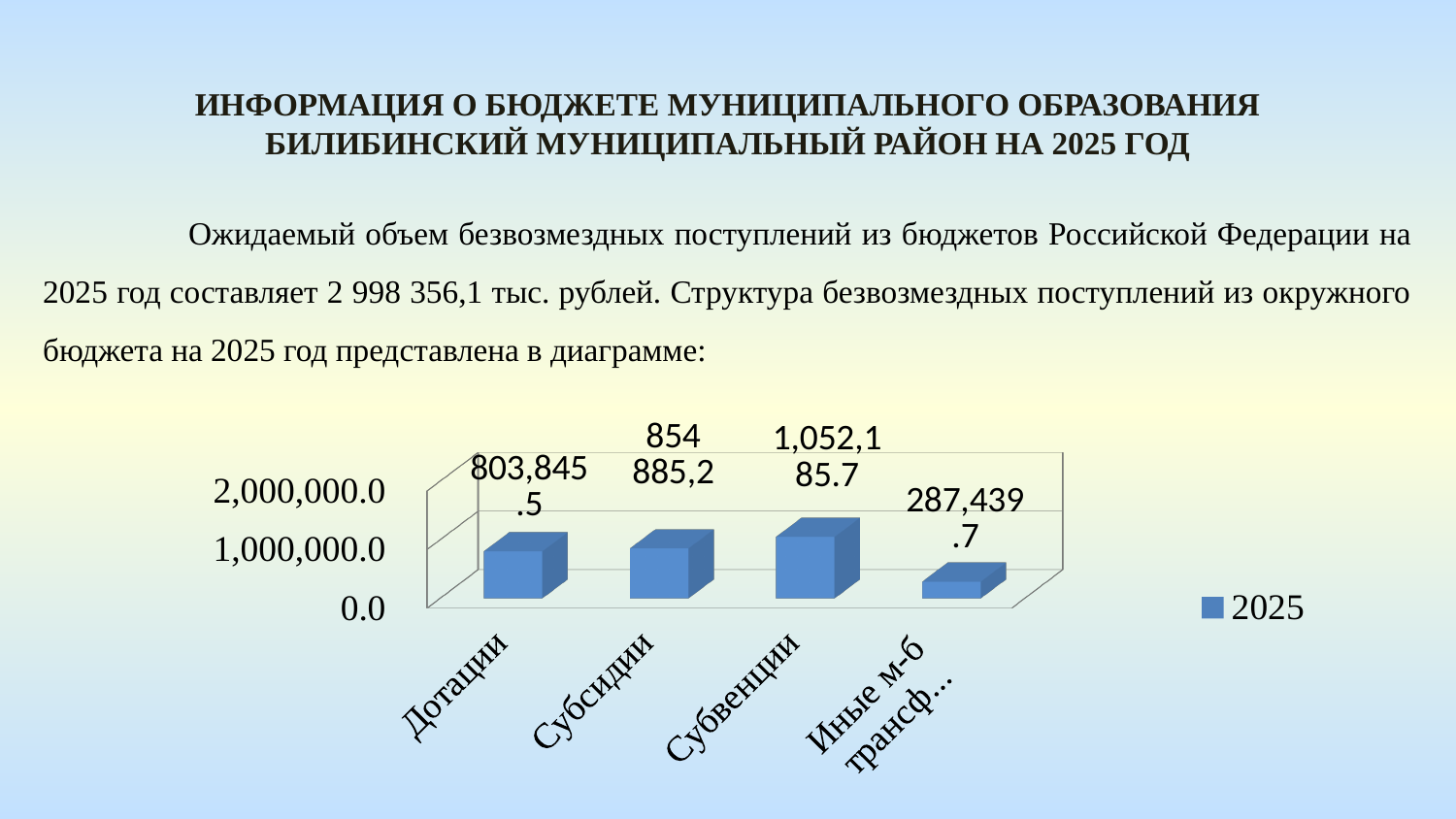
Is the value for Субвенции greater or less than 1,000,000.0? greater Which category has the highest value? Субвенции Which category has the lowest value? Иные м-б трансф... What is the value for Субвенции? 1,052,185.7 What is the value for Дотации? 803,845.5 What is the difference between the values for Субвенции and Дотации? 248,340.2 What is the value for Иные м-б трансф...? 287,439.7 How many series does the legend list? 1 How many categories are shown on the x axis? 4 Which is larger, the value for Дотации or the value for Субсидии? Субсидии What kind of chart is shown on the slide? bar chart What is the difference between the values for Дотации and Иные м-б трансф...? 516,405.8